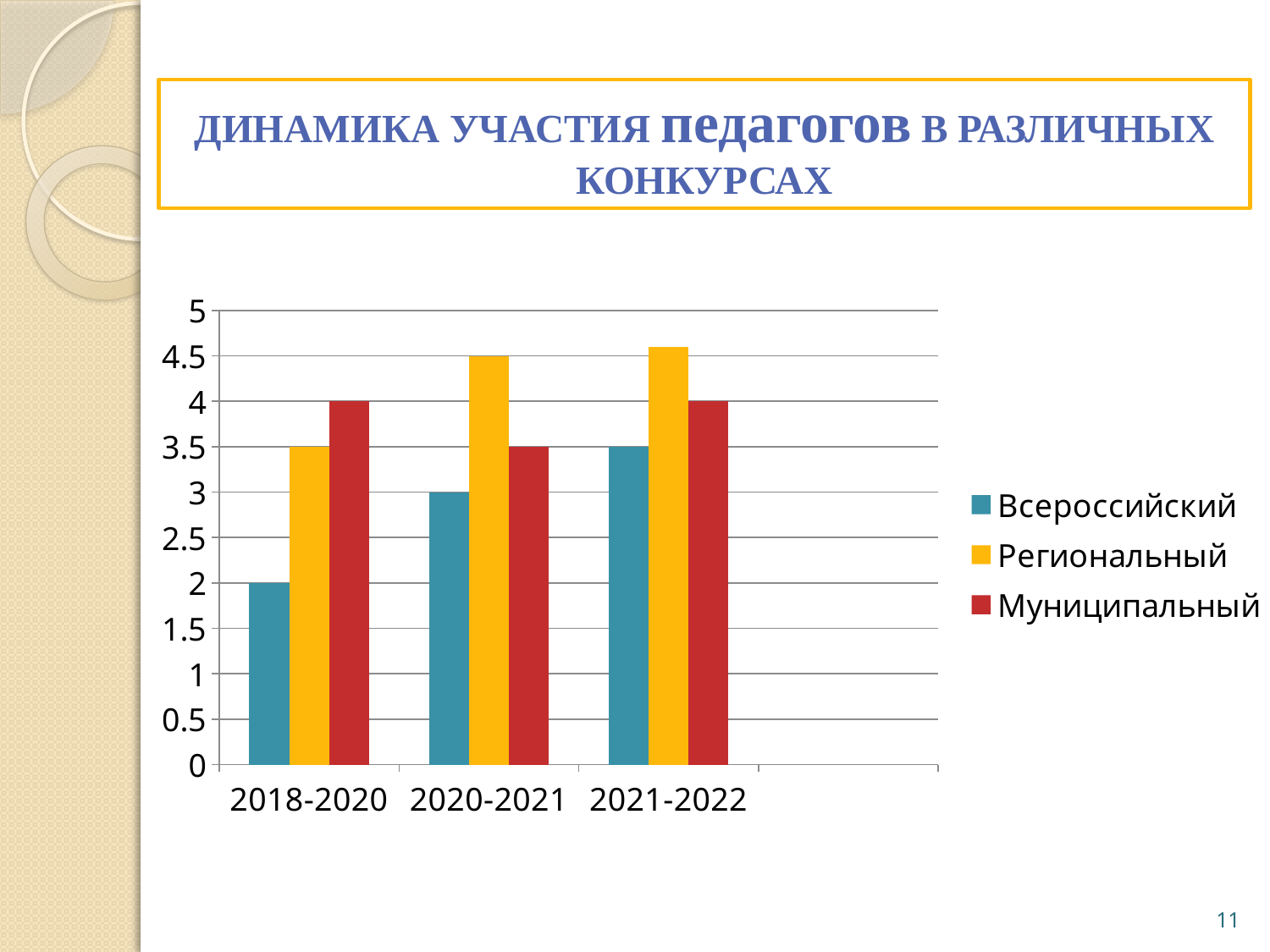
What is the value for Всероссийский in 2018-2020? 2 What is the value for Региональный in 2020-2021? 4.5 How many series does the legend list? 3 Which colour represents the Региональный series in the legend? yellow Which series has the lowest value in 2020-2021? Всероссийский Is the value for Региональный in 2021-2022 greater or less than 4? greater What kind of chart is shown on the slide? bar chart Which series has the highest value in 2018-2020? Муниципальный How many period categories are shown on the x axis? 3 What is the value for Всероссийский in 2021-2022? 3.5 What is the value for Муниципальный in 2018-2020? 4 Does the value for Всероссийский rise or fall from 2018-2020 to 2021-2022? rise